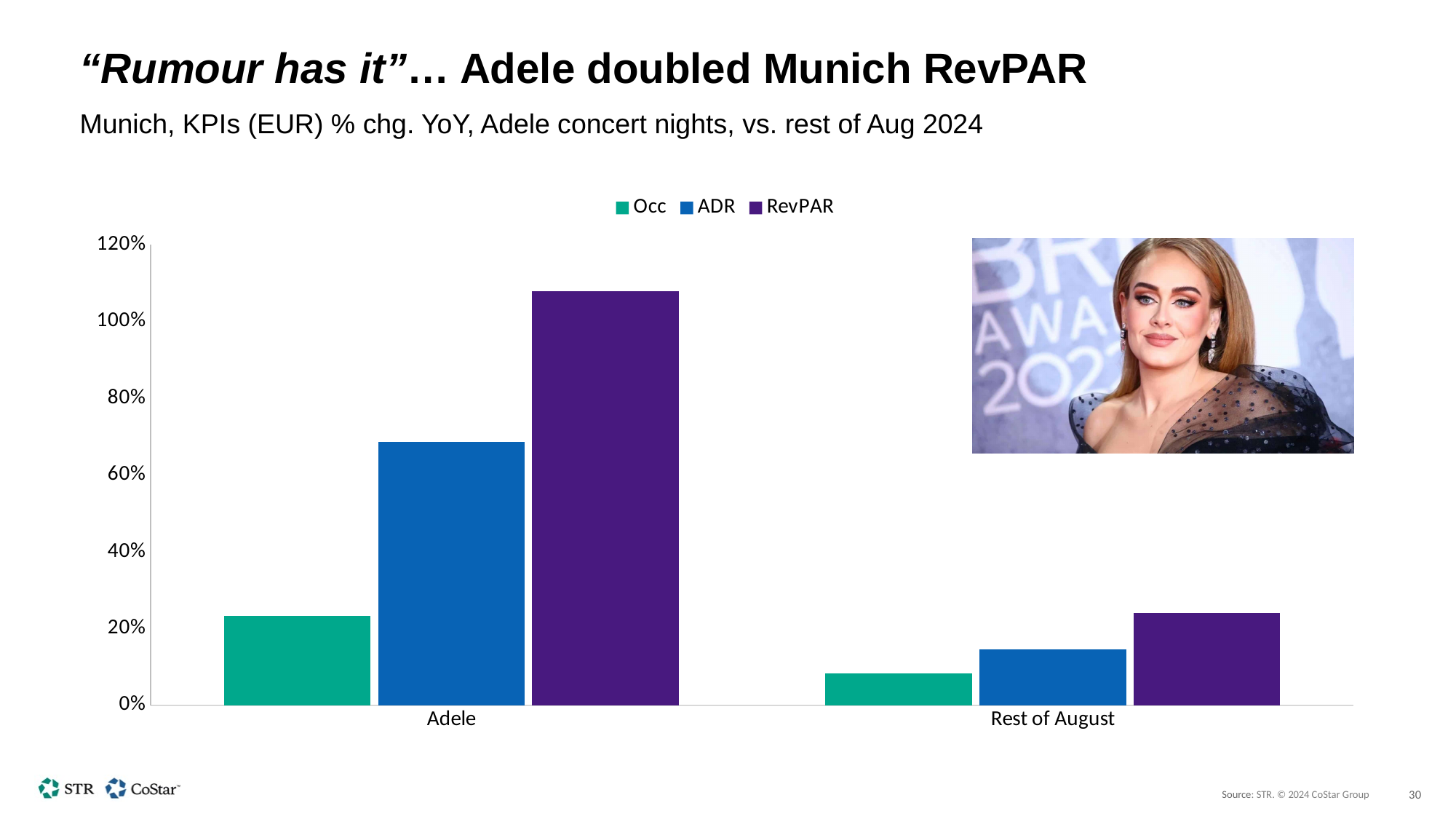
Is the ADR value for Adele greater or less than 60%? greater What colour are the RevPAR bars? purple Which is larger, the ADR value for Adele or the ADR value for Rest of August? Adele Which series has the highest value for Adele? RevPAR Is the Occ value for Rest of August greater or less than 20%? less Is the RevPAR value for Rest of August greater or less than 40%? less What kind of chart is shown on the slide? bar chart How many categories are shown on the x axis? 2 Which series has the lowest value for Rest of August? Occ How many series does the legend list? 3